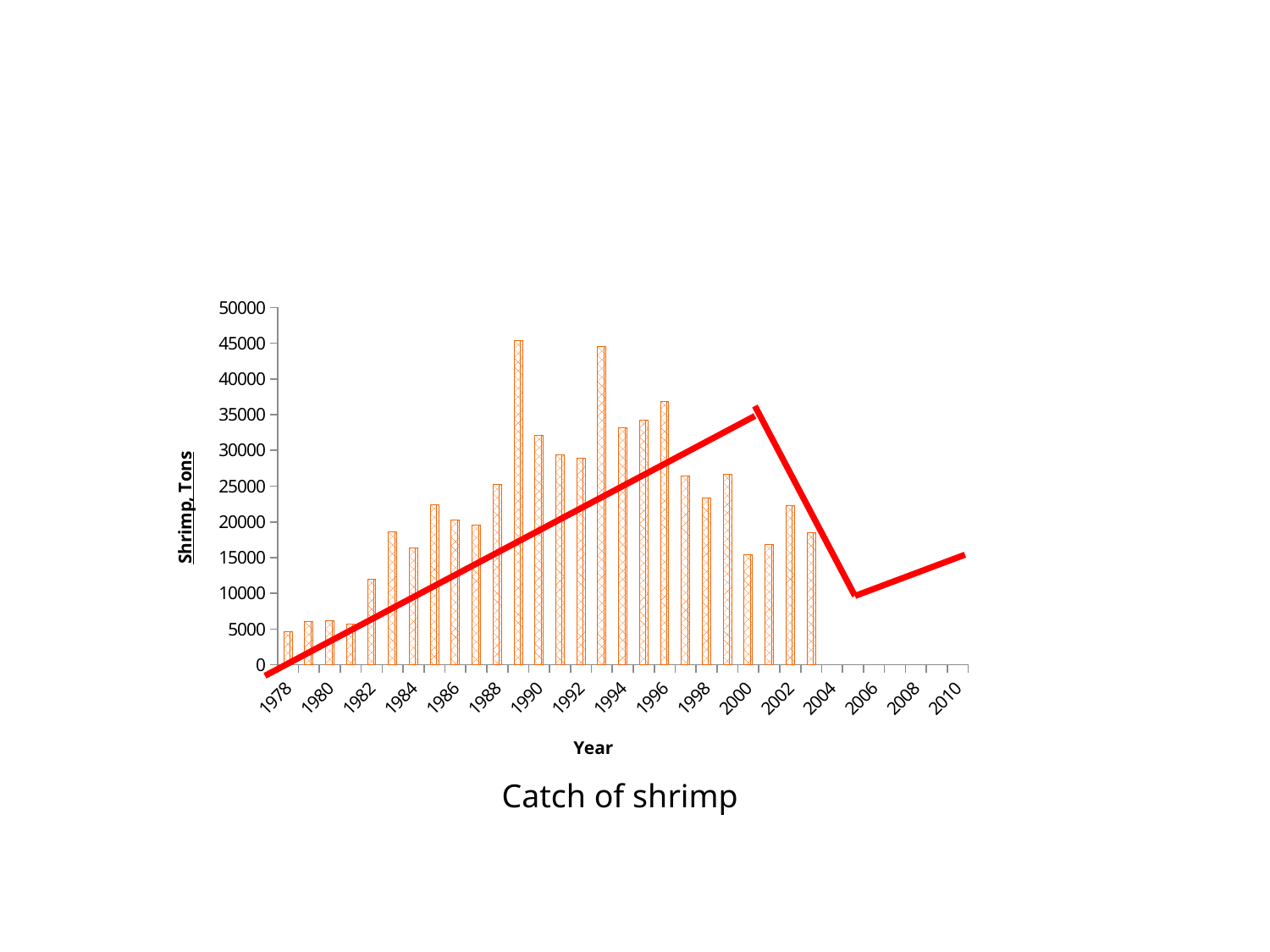
Which year has the lowest shrimp catch? 1978 What is the label on the vertical axis of the chart? Shrimp, Tons Which year has the larger shrimp catch, 1996 or 1997? 1996 Is the value for 2000 greater or less than 20000? less Is the value for 1989 greater or less than 40000? greater What kind of chart is shown on the slide? bar chart Do the shrimp catch values generally rise or fall from 1978 to 1989? rise Which year has the larger shrimp catch, 1990 or 1992? 1990 What is the title of the chart? Catch of shrimp Is the value for 1996 greater or less than 35000? greater